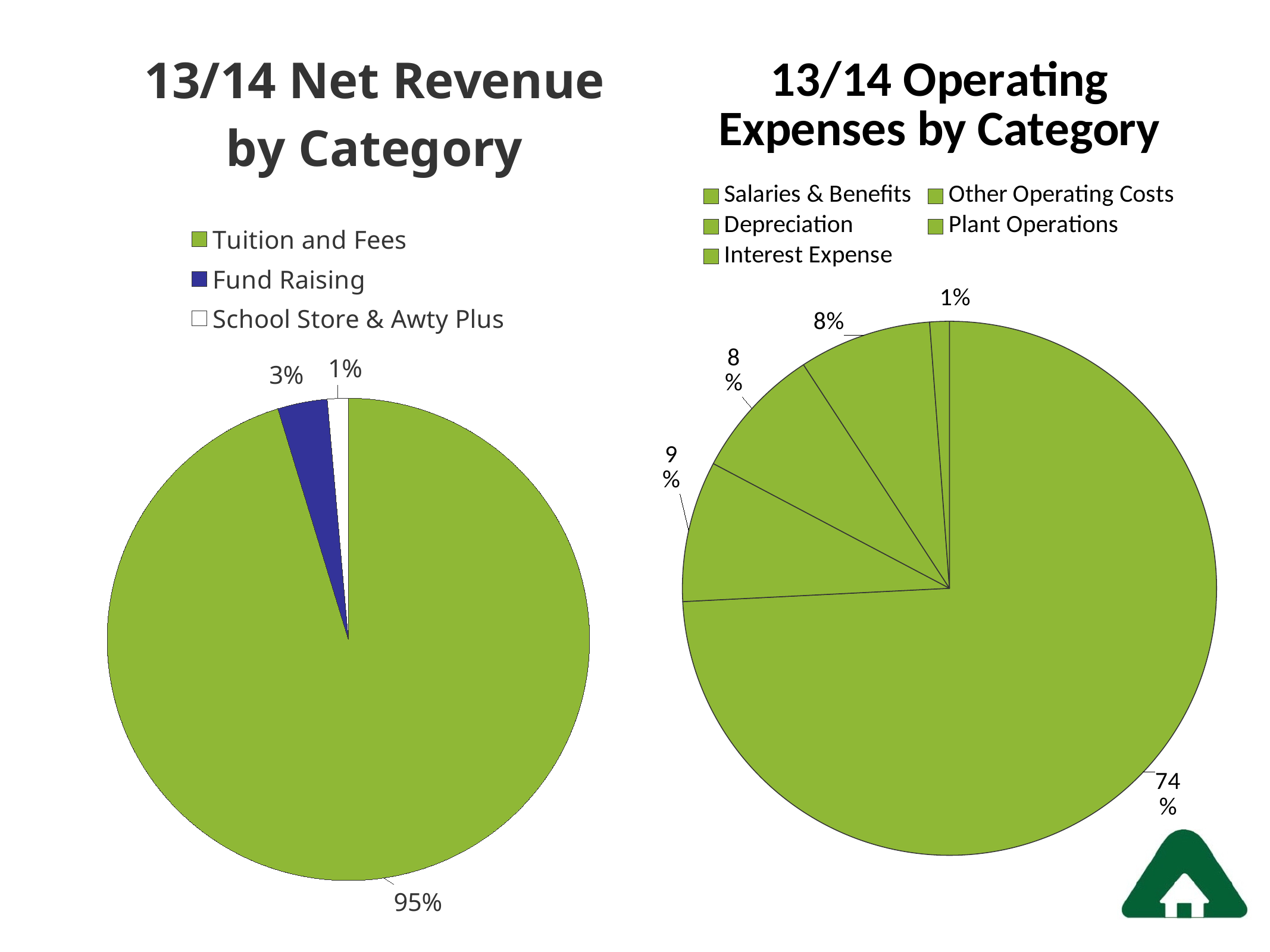
In the 13/14 Net Revenue by Category chart, which category has the largest share? Tuition and Fees What type of chart is the 13/14 Operating Expenses by Category chart? Pie chart In the 13/14 Net Revenue by Category chart, what colour is the Fund Raising slice? Blue In the 13/14 Operating Expenses by Category chart, what is the share of the largest slice? 74% In the 13/14 Net Revenue by Category chart, what share does School Store & Awty Plus have? 1% How many categories does the legend of the 13/14 Net Revenue by Category chart list? 3 In the 13/14 Net Revenue by Category chart, what share does Tuition and Fees have? 95% In the 13/14 Net Revenue by Category chart, which is larger, Fund Raising or School Store & Awty Plus? Fund Raising In the 13/14 Net Revenue by Category chart, what share does Fund Raising have? 3% In the 13/14 Net Revenue by Category chart, what is the difference in percentage points between Tuition and Fees and Fund Raising? 92 In the 13/14 Net Revenue by Category chart, which category has the smallest share? School Store & Awty Plus How many categories does the legend of the 13/14 Operating Expenses by Category chart list? 5